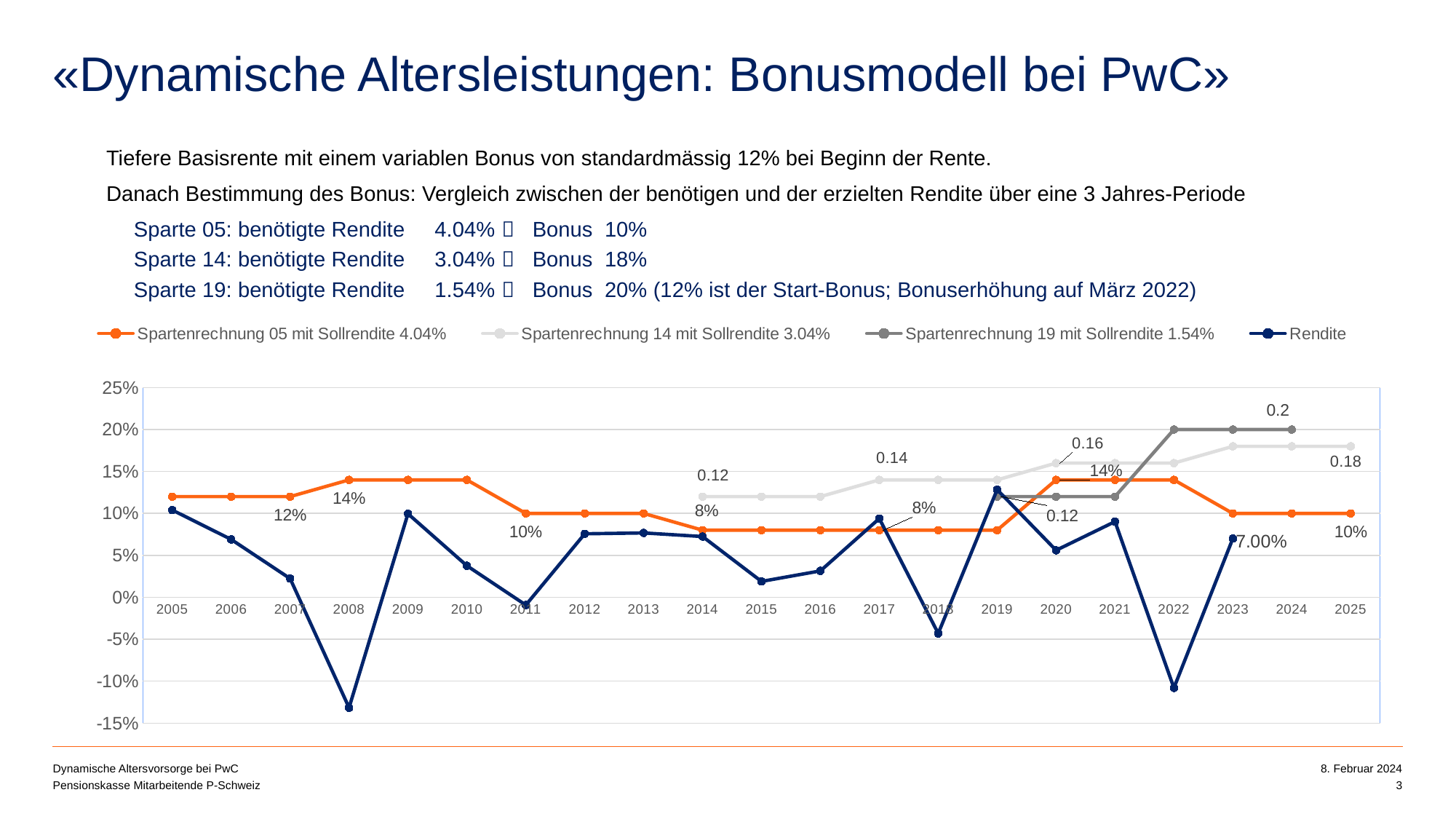
What is the value of the Rendite series in 2023? 7.00% By how many percentage points does Spartenrechnung 05 mit Sollrendite 4.04% fall from 2008 to 2011? 4 percentage points How many years are shown on the x axis of the chart? 21 What is the value of Spartenrechnung 14 mit Sollrendite 3.04% in 2025? 0.18 Is the Rendite value for 2019 greater or less than 10%? greater In 2020, which is larger: Spartenrechnung 05 mit Sollrendite 4.04% or Spartenrechnung 14 mit Sollrendite 3.04%? Spartenrechnung 14 mit Sollrendite 3.04% What is the value of Spartenrechnung 19 mit Sollrendite 1.54% in 2024? 0.2 What is the value of Spartenrechnung 05 mit Sollrendite 4.04% in 2008? 14% How many series does the chart legend list? 4 Is the Rendite value for 2022 greater or less than -10%? less In which year does the Rendite series reach its lowest value? 2008 What kind of chart is shown on the slide? Line chart